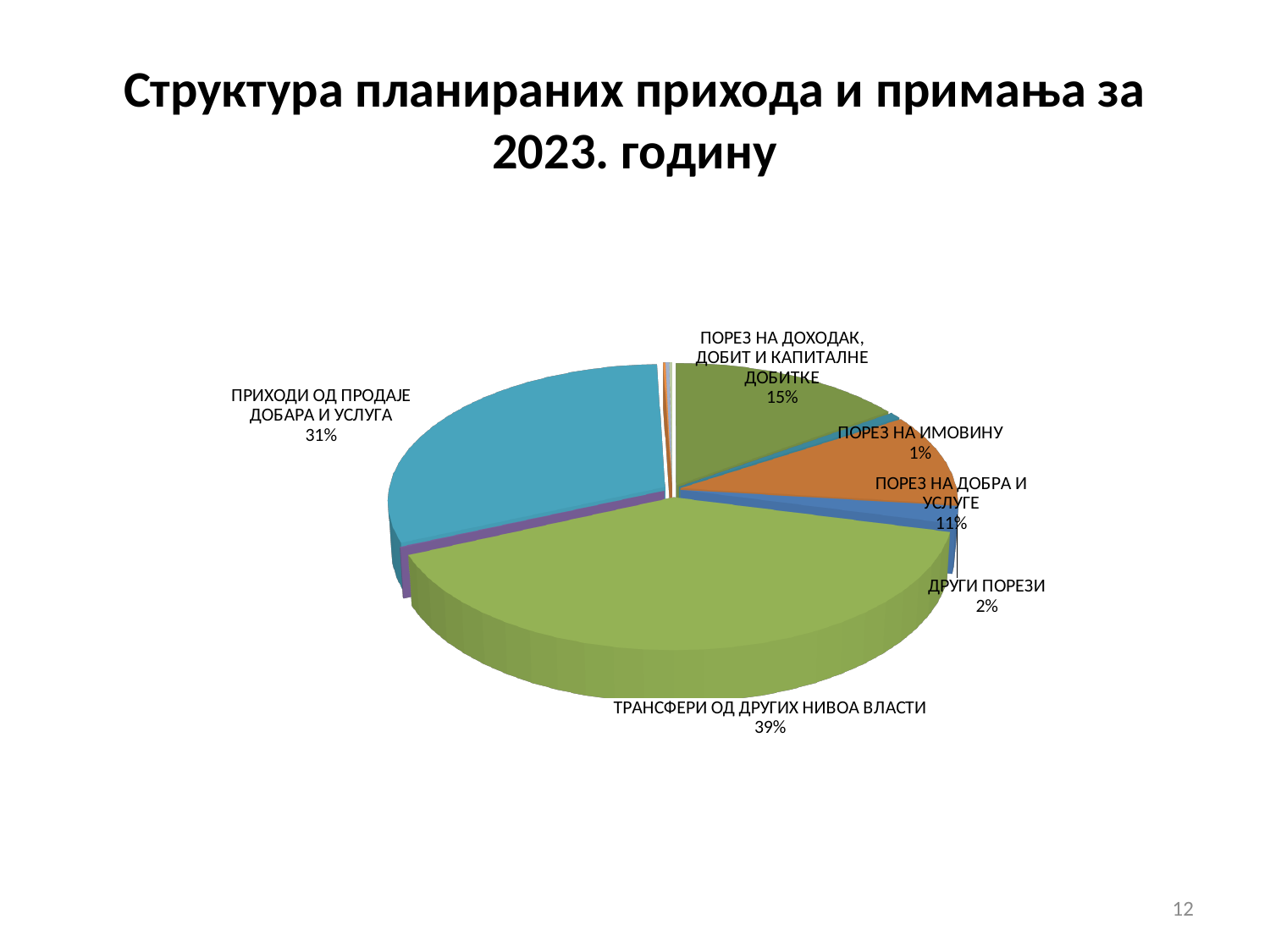
What percentage is shown for ПОРЕЗ НА ИМОВИНУ? 1% What is the title of the slide containing the chart? Структура планираних прихода и примања за 2023. годину Which is larger, the share for ПОРЕЗ НА ДОХОДАК, ДОБИТ И КАПИТАЛНЕ ДОБИТКЕ or the share for ПОРЕЗ НА ДОБРА И УСЛУГЕ? ПОРЕЗ НА ДОХОДАК, ДОБИТ И КАПИТАЛНЕ ДОБИТКЕ What kind of chart is shown on the slide? pie chart What share of the pie is ТРАНСФЕРИ ОД ДРУГИХ НИВОА ВЛАСТИ? 39% What percentage is shown for ПОРЕЗ НА ДОХОДАК, ДОБИТ И КАПИТАЛНЕ ДОБИТКЕ? 15% Which labelled category has the smallest share of the pie? ПОРЕЗ НА ИМОВИНУ What percentage is shown for ПОРЕЗ НА ДОБРА И УСЛУГЕ? 11% What is the difference in percentage points between ТРАНСФЕРИ ОД ДРУГИХ НИВОА ВЛАСТИ and ПРИХОДИ ОД ПРОДАЈЕ ДОБАРА И УСЛУГА? 8 percentage points What percentage is shown for ДРУГИ ПОРЕЗИ? 2% Which labelled category has the largest share of the pie? ТРАНСФЕРИ ОД ДРУГИХ НИВОА ВЛАСТИ What share of the pie is ПРИХОДИ ОД ПРОДАЈЕ ДОБАРА И УСЛУГА? 31%